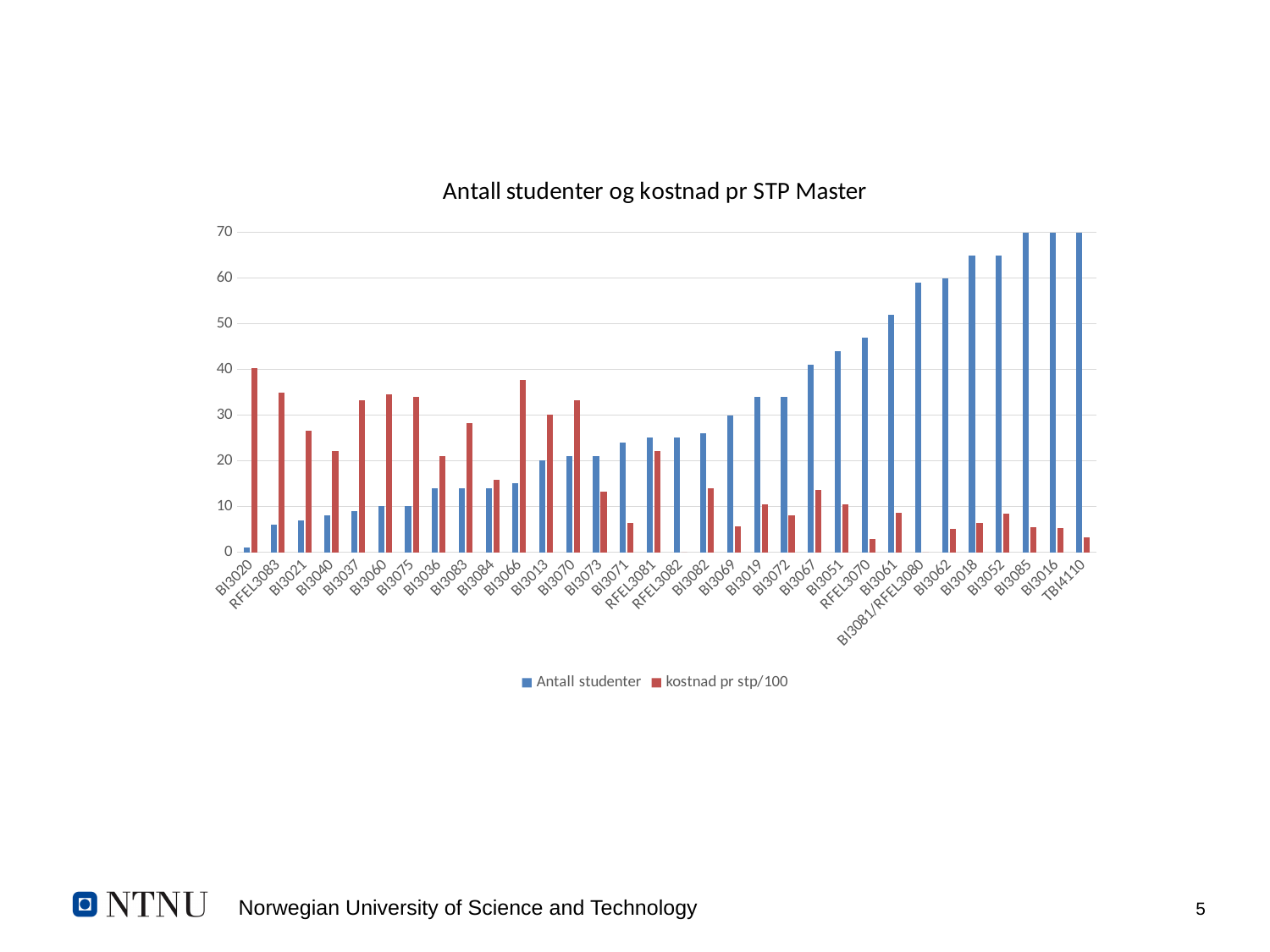
Is the value of kostnad pr stp/100 for RFEL3070 greater or less than 10? less What kind of chart is shown on the slide? bar chart Which category has the highest value for kostnad pr stp/100? BI3020 What is the title of the chart? Antall studenter og kostnad pr STP Master How many course categories are shown on the x axis? 32 Is the value of Antall studenter for BI3018 greater or less than 60? greater How many series does the legend list? 2 What is the value of Antall studenter for BI3062? 60 Does Antall studenter generally rise or fall from left to right along the x axis? rise Which category has the lowest value for Antall studenter? BI3020